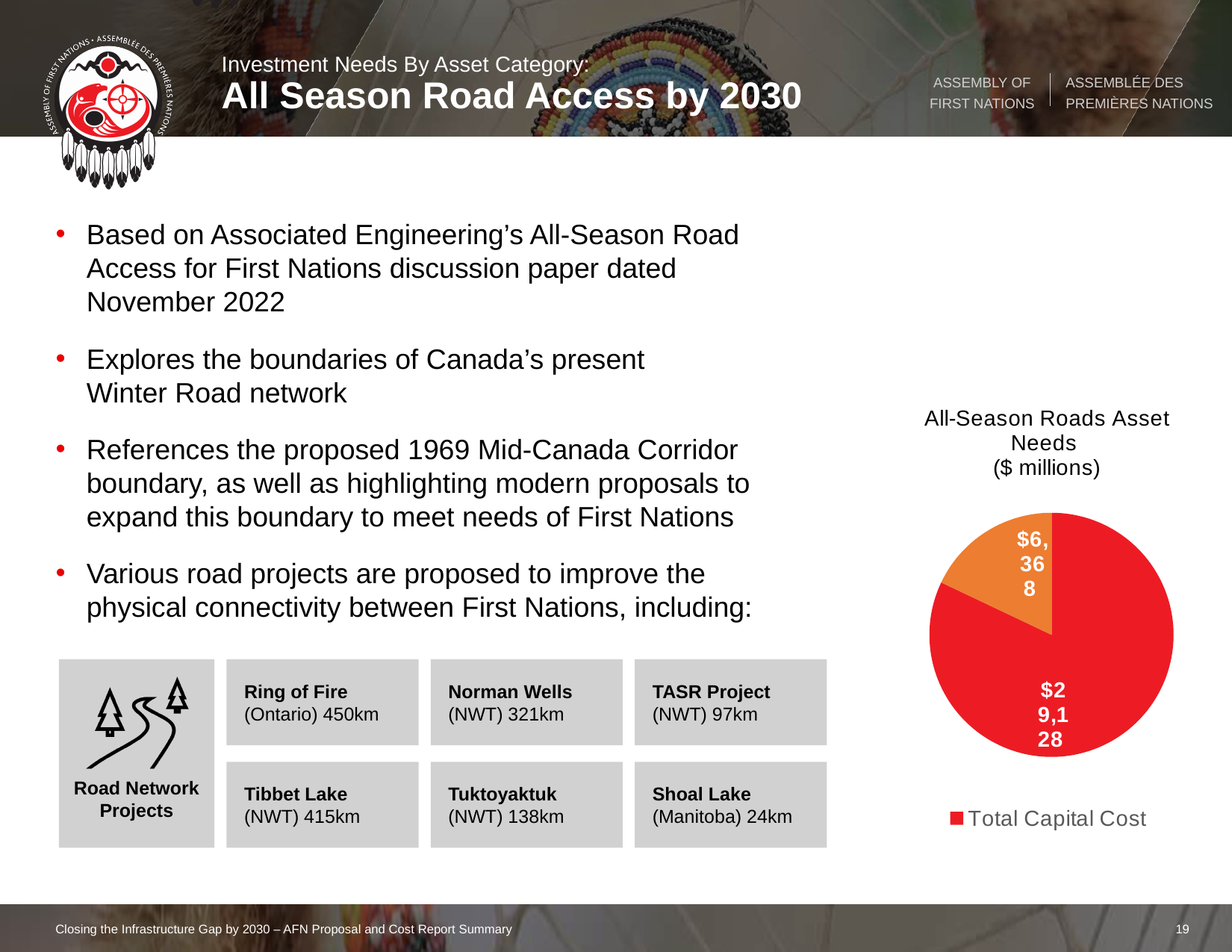
Which slice is larger in the pie chart, the red slice or the orange slice? the red slice ($29,128) How many slices does the pie chart have? 2 What is the title of the chart on the slide? All-Season Roads Asset Needs ($ millions) What is the value of the smallest slice in the pie chart? $6,368 How many entries does the chart's legend list? 1 What is the difference between the two slice values in the pie chart? $22,760 What is the total of the two slice values in the pie chart? $35,496 What is the value of the largest slice in the pie chart? $29,128 What value is shown for the Total Capital Cost slice of the pie chart? $29,128 What kind of chart is shown on the slide? pie chart What share of the pie does the $29,128 slice represent? 82% What is the only entry shown in the chart's legend? Total Capital Cost